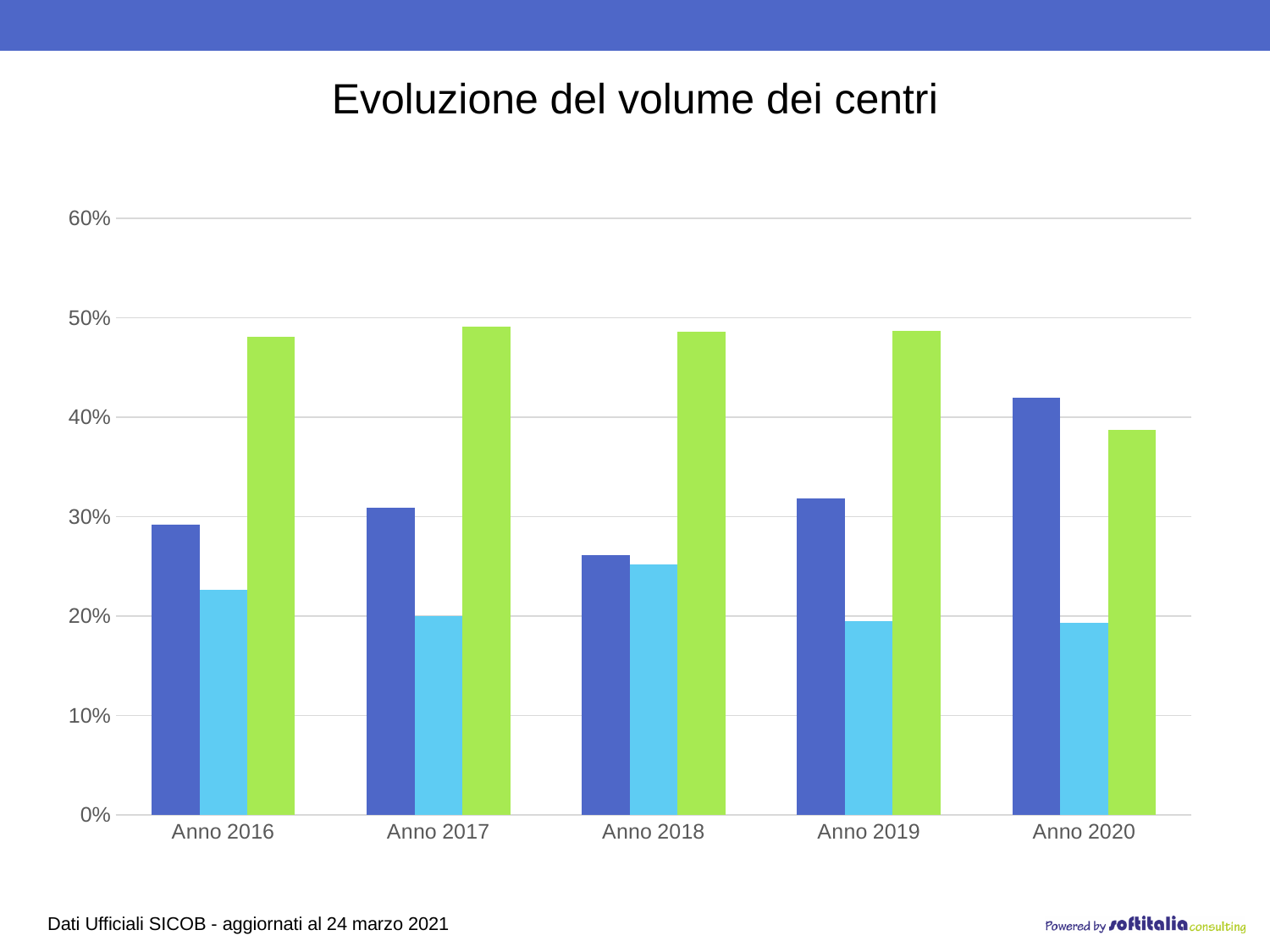
Does the green bar rise or fall from Anno 2019 to Anno 2020? Fall In which year is the green bar the lowest? Anno 2020 Is the green bar for Anno 2016 greater or less than 50%? less How many year categories are shown on the x axis? 5 Is the dark blue bar for Anno 2020 greater or less than 40%? greater In Anno 2020, which is larger: the dark blue bar or the green bar? The dark blue bar How many bars are shown for each year? 3 What kind of chart is shown on the slide? Bar chart Is the dark blue bar for Anno 2018 greater or less than 30%? less What is the title of the chart? Evoluzione del volume dei centri In which year is the dark blue bar the highest? Anno 2020 In which year is the light blue bar the highest? Anno 2018